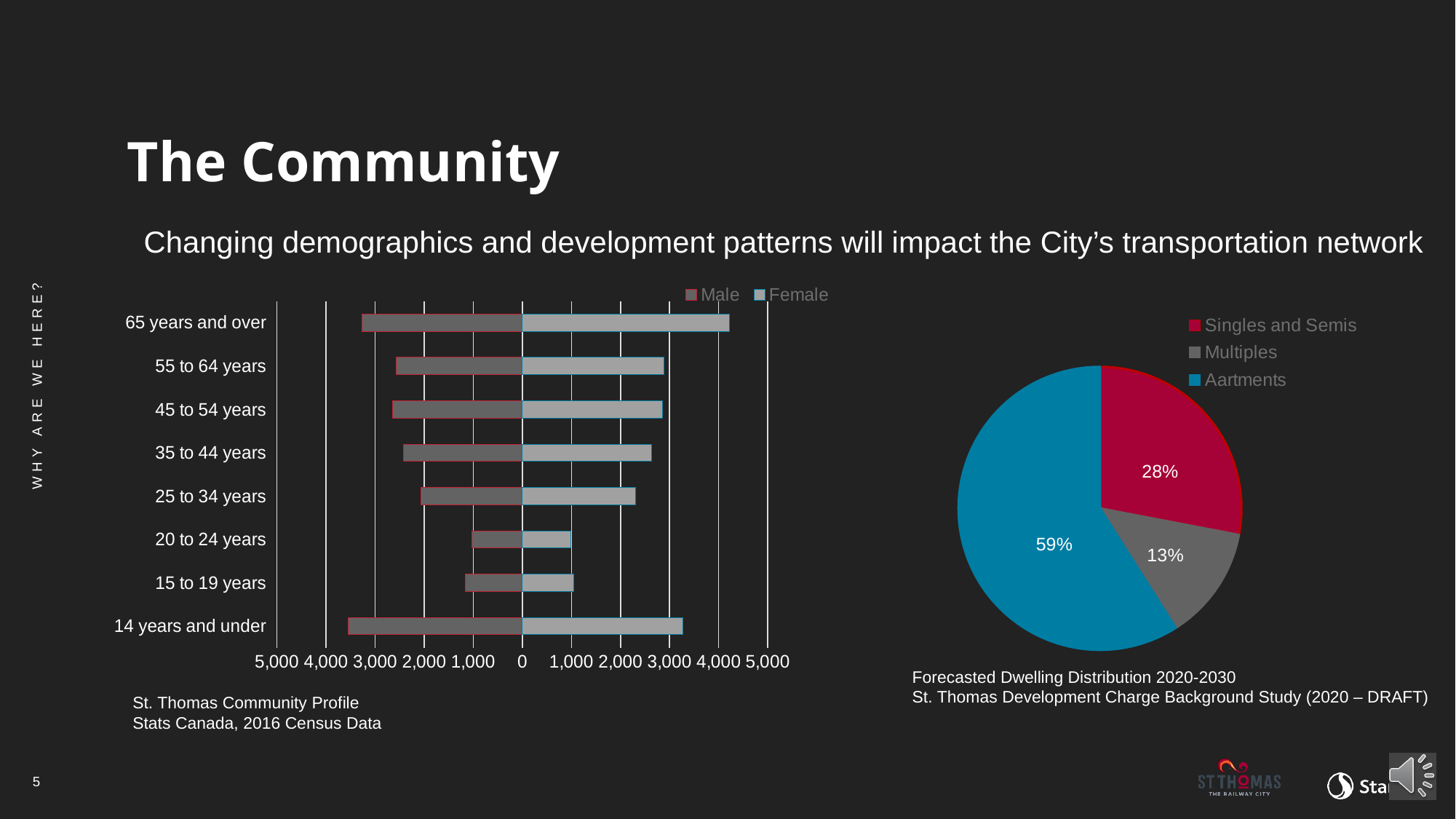
In the bar chart on the left, which age group has the longest Female bar? 65 years and over In the bar chart on the left, is the Female value for 65 years and over greater or less than 4,000? greater In the pie chart on the right, what share is labelled for the Multiples slice? 13% In the pie chart on the right, which category has the largest slice? Aartments In the bar chart on the left, how many age groups are shown? 8 In the pie chart on the right, which category has the smallest slice? Multiples In the bar chart on the left, is the Male value for 65 years and over greater or less than 3,000? greater In the pie chart on the right, how many categories does the legend list? 3 In the bar chart on the left, how many series does the legend list? 2 What kind of chart is the chart on the left of the slide? Bar chart In the pie chart on the right, what share is labelled for the Singles and Semis slice? 28% In the pie chart on the right, how many percentage points larger is the Aartments slice than the Multiples slice? 46